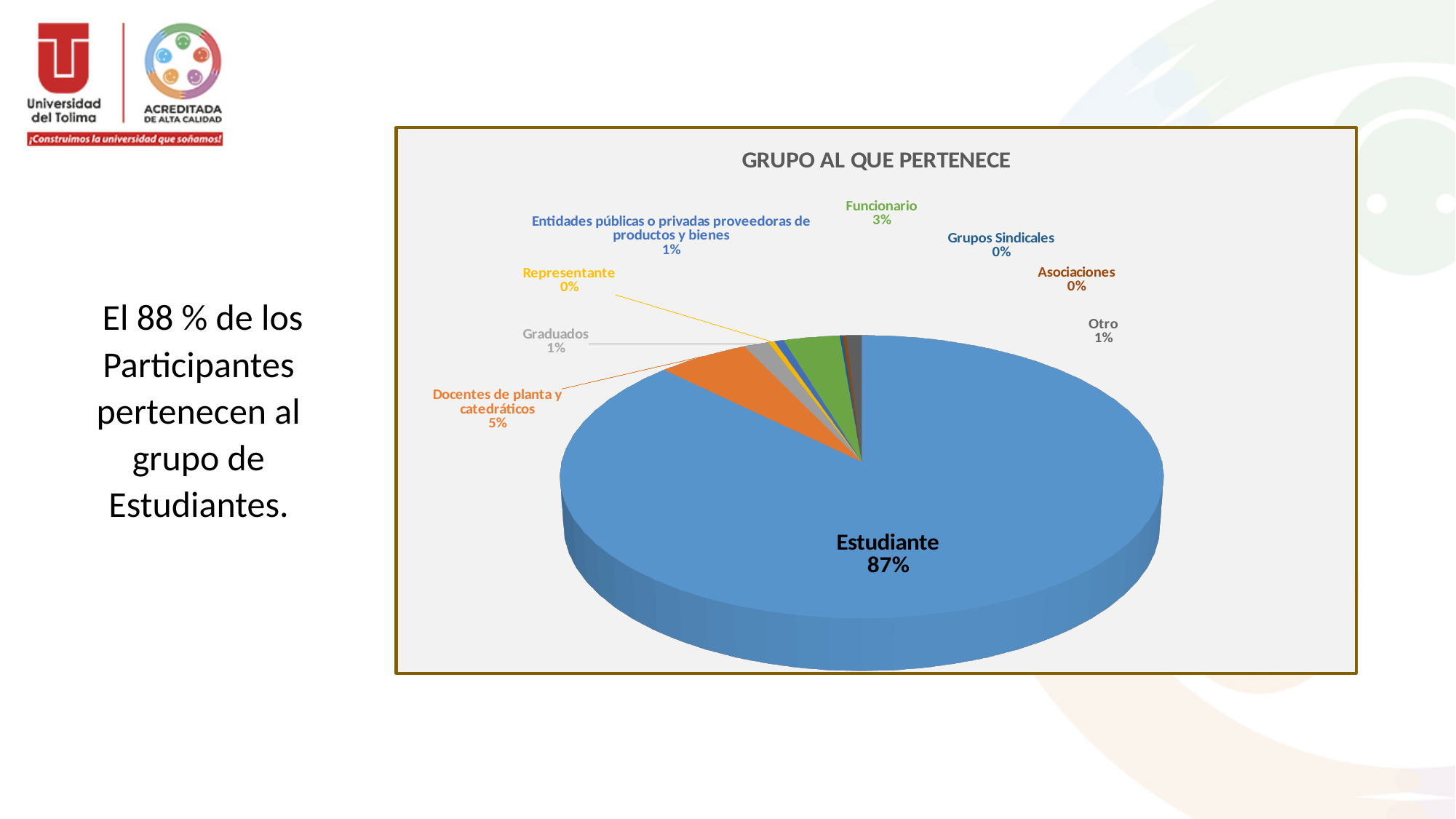
Which is larger, the share for Funcionario or the share for Docentes de planta y catedráticos? Docentes de planta y catedráticos What percentage is shown for Funcionario? 3% What percentage is shown for Docentes de planta y catedráticos? 5% What percentage is shown for Grupos Sindicales? 0% Which category has the largest share of the pie? Estudiante What is the difference in percentage points between Estudiante and Docentes de planta y catedráticos? 82 What colour is the Estudiante slice? Blue What percentage of the pie does the Estudiante slice represent? 87% How many categories are labelled in the pie chart? 9 What kind of chart is shown on the slide? Pie chart What percentage is shown for Graduados? 1% What is the title of the chart? GRUPO AL QUE PERTENECE